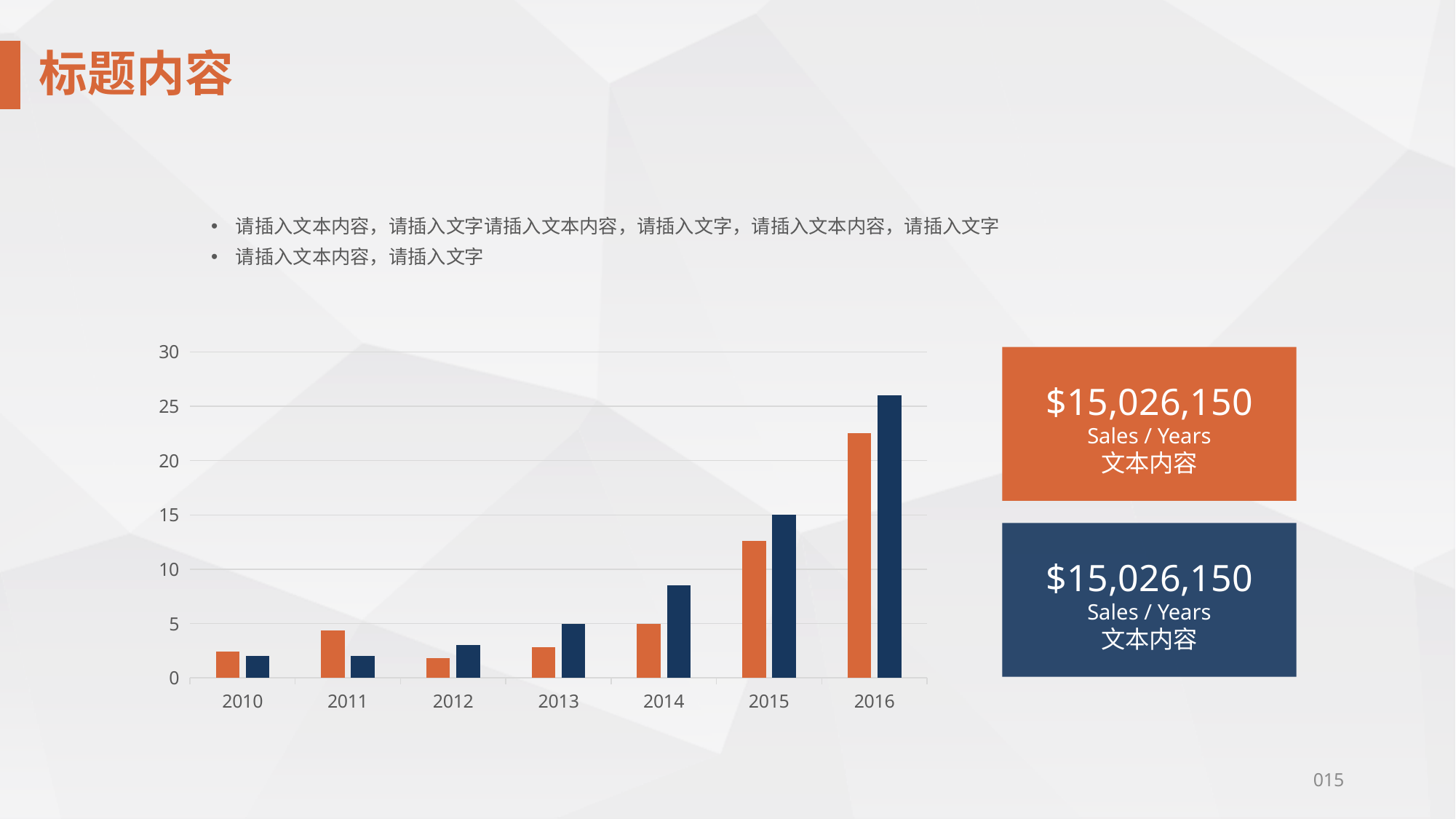
Do the bar values generally rise or fall from 2010 to 2016? rise In 2016, which bar is taller, the orange one or the dark blue one? dark blue Is the dark blue bar for 2014 greater or less than 10? less Is the orange bar for 2011 greater or less than 5? less Is the orange bar for 2016 greater or less than 20? greater Which year has the tallest bar in the chart? 2016 What is the highest value shown on the chart's y axis? 30 What kind of chart is shown on the slide? bar chart In 2011, which bar is taller, the orange one or the dark blue one? orange How many years are shown on the x axis of the chart? 7